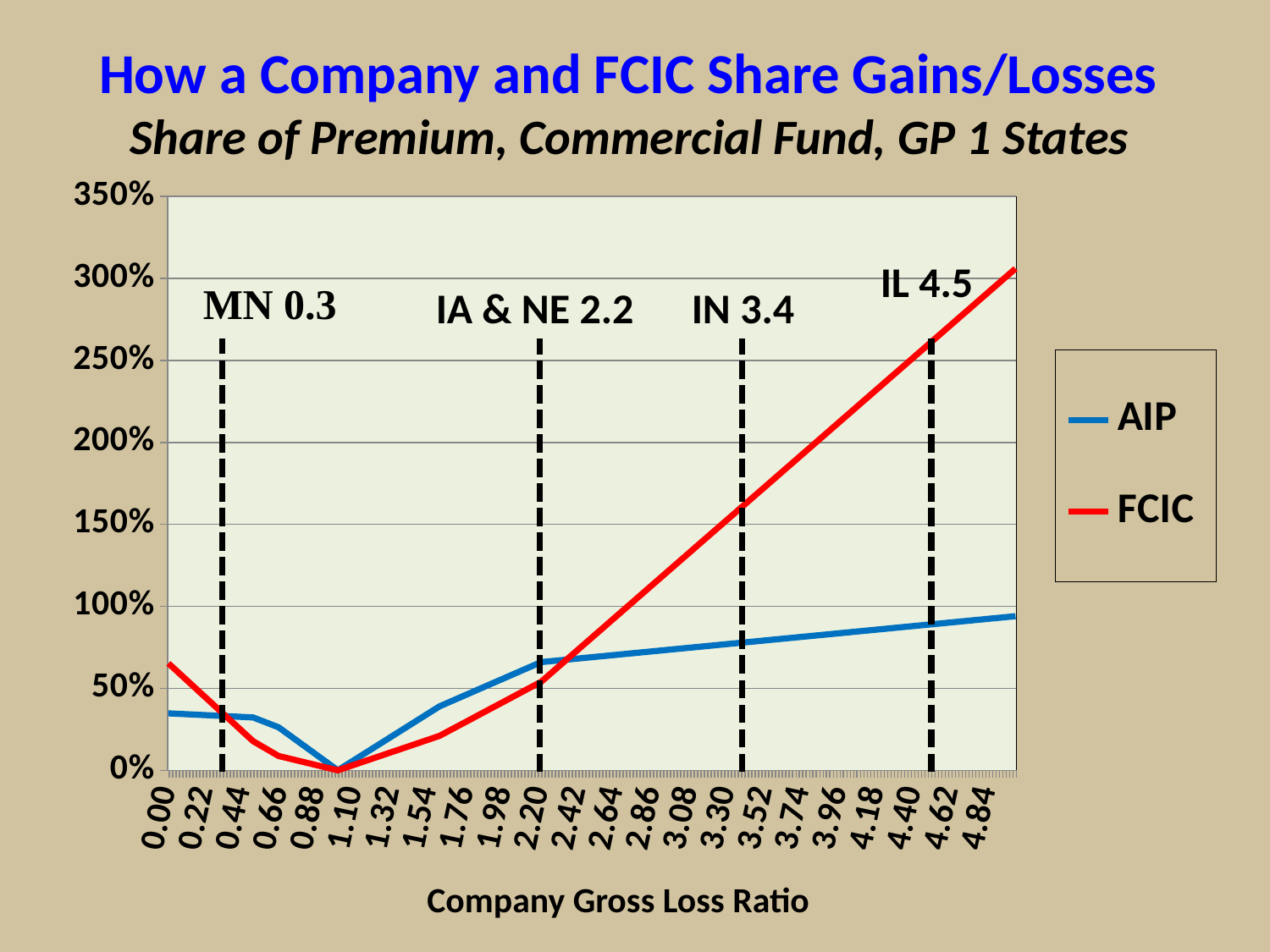
What kind of chart is shown on the slide? line chart What is the title of the x axis? Company Gross Loss Ratio Does the FCIC line rise or fall as the Company Gross Loss Ratio increases from 2.20 to 4.84? rise Is the FCIC value at a Company Gross Loss Ratio of 4.84 greater or less than 250%? greater At a Company Gross Loss Ratio of 0.00, which series has the higher value, AIP or FCIC? FCIC How many series does the legend list? 2 Is the FCIC value at a Company Gross Loss Ratio of 3.30 greater or less than 100%? greater Is the AIP value at a Company Gross Loss Ratio of 3.30 greater or less than 100%? less At a Company Gross Loss Ratio of 3.30, which series has the higher value, AIP or FCIC? FCIC What are the two series named in the legend? AIP and FCIC At a Company Gross Loss Ratio of 1.76, which series has the higher value, AIP or FCIC? AIP